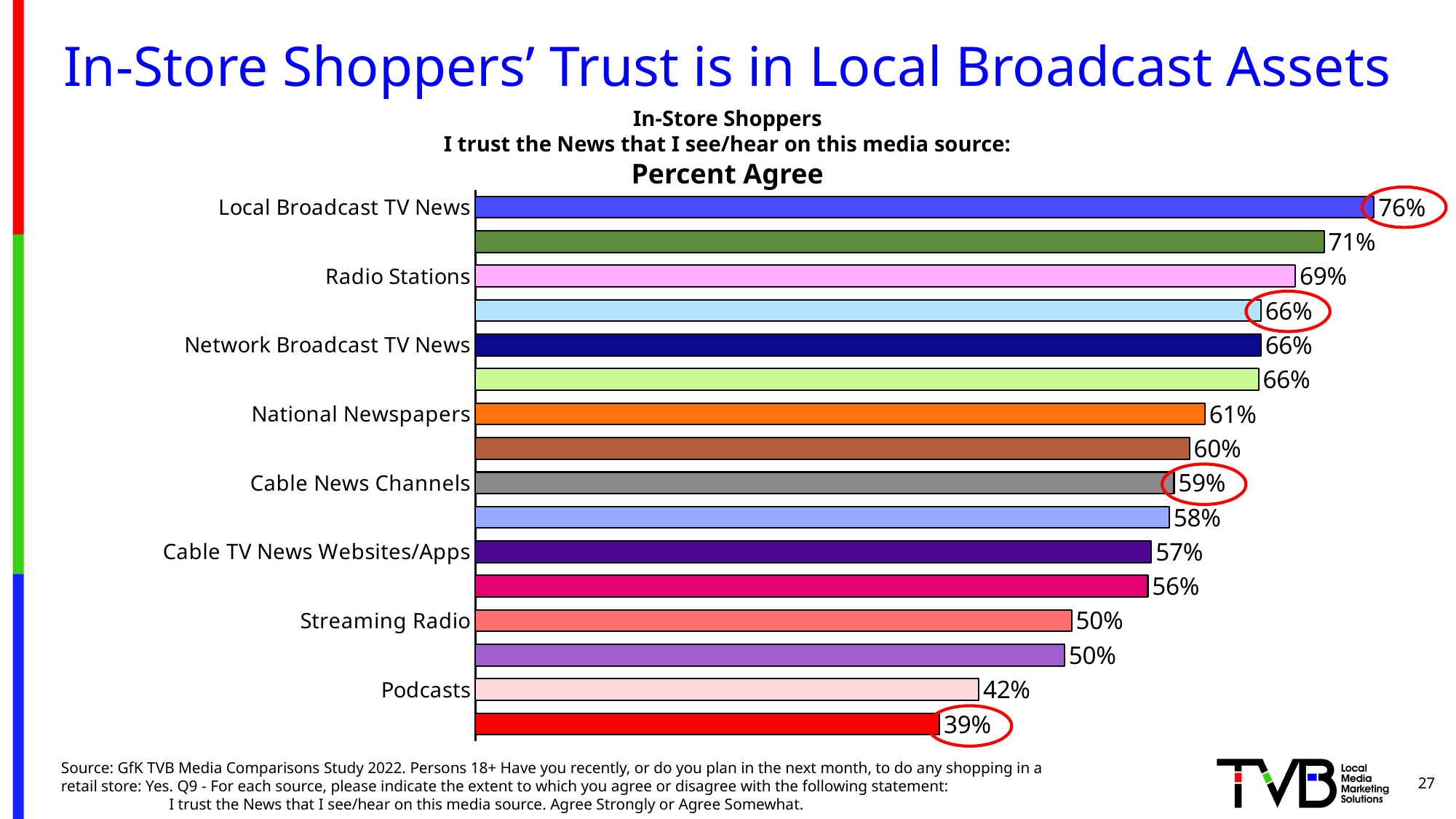
What kind of chart is shown on the slide? Bar chart What is the difference in Percent Agree between Local Broadcast TV News and Cable News Channels? 17 percentage points Which media source has the highest Percent Agree value? Local Broadcast TV News What is the Percent Agree value for Radio Stations? 69% Which has a higher Percent Agree value, Radio Stations or National Newspapers? Radio Stations What is the Percent Agree value for Cable News Channels? 59% Do the bar values increase or decrease from the top of the chart to the bottom? Decrease What is the lowest Percent Agree value shown on the chart? 39% What is the Percent Agree value for Streaming Radio? 50% What is the Percent Agree value for Local Broadcast TV News? 76% What is the Percent Agree value for Podcasts? 42% How many bars are plotted on the chart? 16